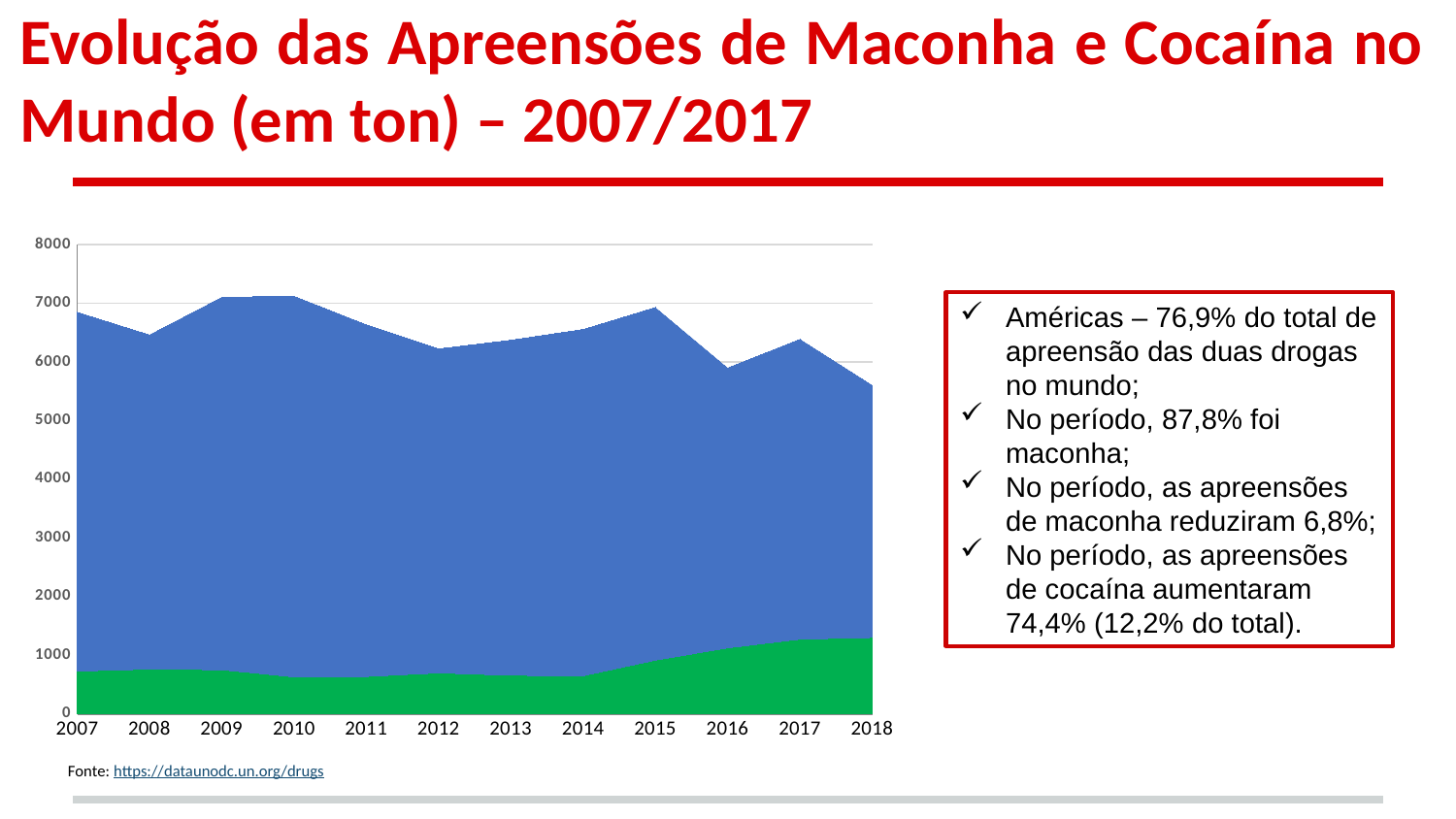
Is the value of the green series for 2007 greater or less than 1000? less Is the value of the green series for 2018 greater or less than 1000? greater What is the first year shown on the x axis of the chart? 2007 Is the total value for 2018 greater or less than 6000? less How many data series are plotted in the chart? 2 How many years are shown along the x axis of the chart? 12 What kind of chart is shown on the slide? Area chart In which year does the green series reach its highest value? 2018 Does the green series rise or fall from 2014 to 2018? rise Does the total value rise or fall from 2015 to 2016? fall